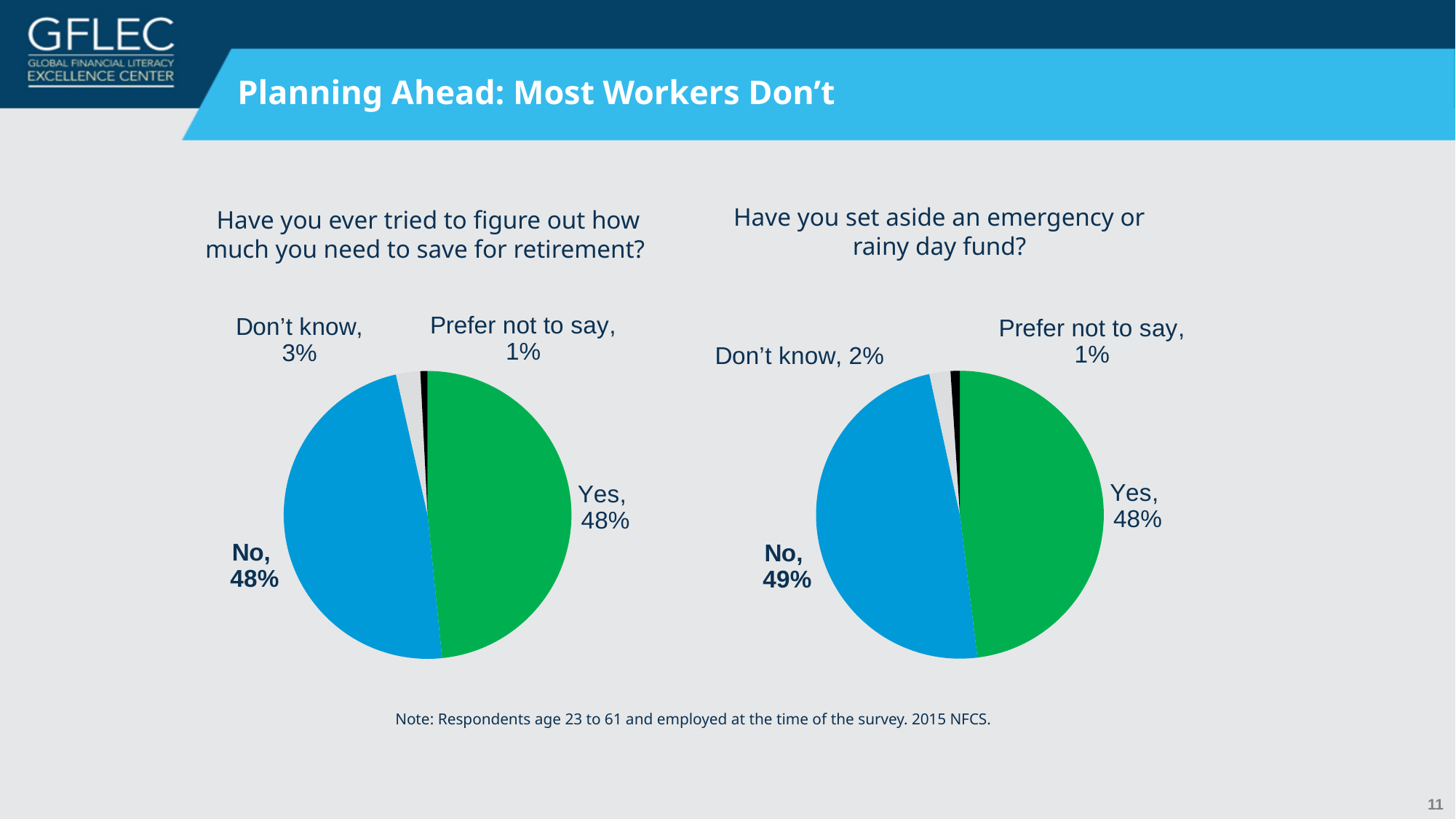
What colour is the "No" slice in both pie charts? Blue What kind of chart is used on the left of the slide for the retirement savings question? Pie chart In the left pie chart (retirement savings question), what share of respondents answered "Yes"? 48% In the left pie chart (retirement savings question), how many slices does the pie have? 4 In the left pie chart (retirement savings question), what is the difference between the "Don't know" share and the "Prefer not to say" share? 2% In the right pie chart (emergency fund question), what is the difference between the "No" share and the "Yes" share? 1% In the left pie chart (retirement savings question), what share of respondents answered "Don't know"? 3% In the right pie chart (emergency fund question), which category has the smallest share? Prefer not to say In the right pie chart (emergency fund question), what share of respondents answered "No"? 49% In the left pie chart (retirement savings question), which category has the smallest share? Prefer not to say In the right pie chart (emergency fund question), what share of respondents answered "Don't know"? 2% In the right pie chart (emergency fund question), which is larger, the "Yes" share or the "Don't know" share? Yes